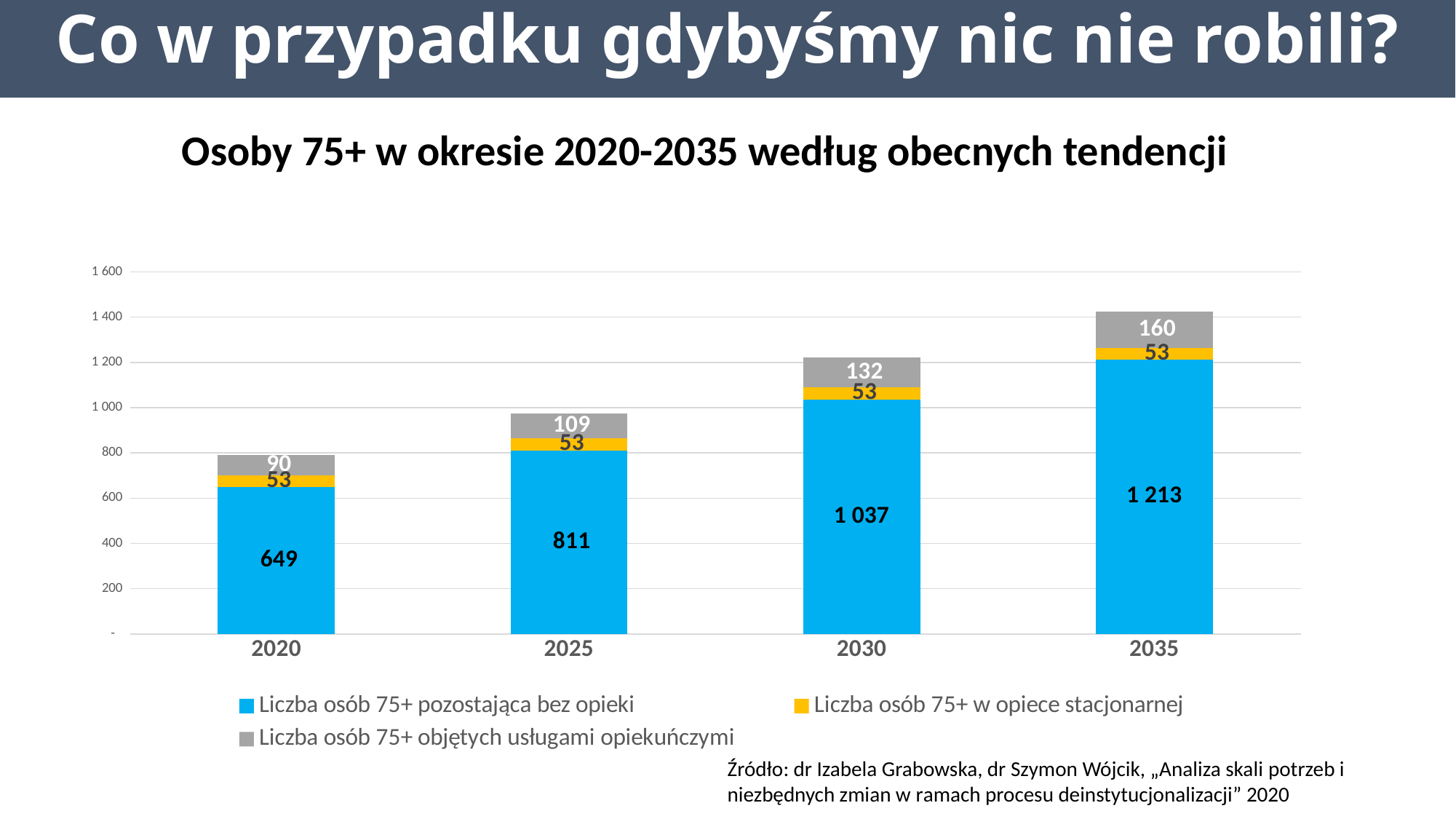
What is the difference between 'Liczba osób 75+ pozostająca bez opieki' in 2035 and in 2020? 564 What is the value for 'Liczba osób 75+ pozostająca bez opieki' in 2020? 649 In which year is 'Liczba osób 75+ pozostająca bez opieki' highest? 2035 Does 'Liczba osób 75+ pozostająca bez opieki' rise or fall from 2020 to 2035? rise What is the total of the stacked bar for 2020? 792 How many series does the legend list? 3 What is the total of the stacked bar for 2030? 1 222 What is the value for 'Liczba osób 75+ objętych usługami opiekuńczymi' in 2035? 160 How many years are shown on the x axis? 4 What is the value for 'Liczba osób 75+ w opiece stacjonarnej' in 2030? 53 Which is larger: 'Liczba osób 75+ objętych usługami opiekuńczymi' in 2025 or in 2030? 2030 In which year is 'Liczba osób 75+ objętych usługami opiekuńczymi' lowest? 2020